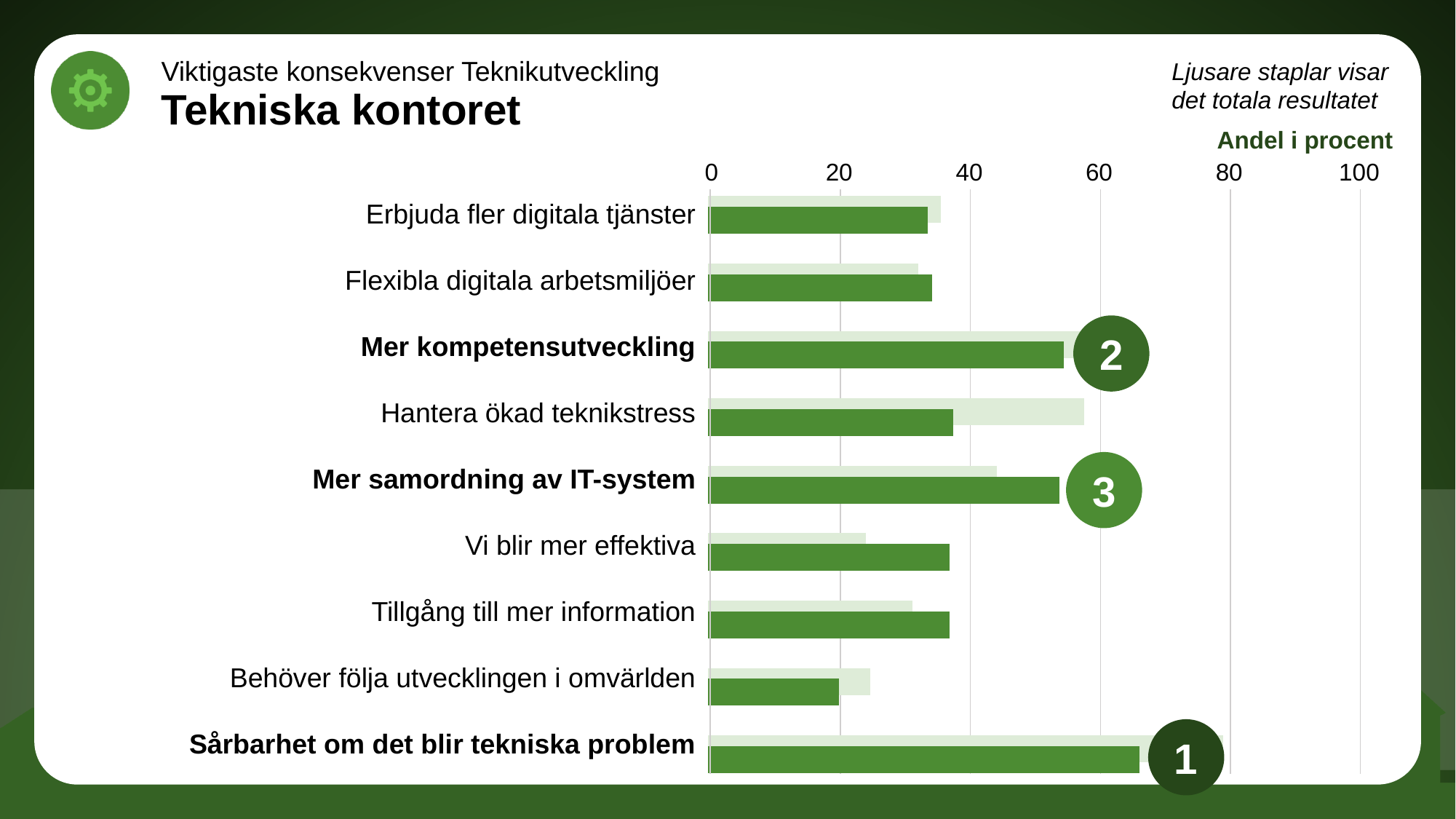
According to the note on the slide, what do the lighter bars show? det totala resultatet How many categories are plotted on the chart? 9 Which category has the highest dark green bar? Sårbarhet om det blir tekniska problem Is the dark green value for Behöver följa utvecklingen i omvärlden greater or less than 40? less Is the light green value for Hantera ökad teknikstress greater or less than 40? greater Which category has the lowest dark green bar? Behöver följa utvecklingen i omvärlden For Hantera ökad teknikstress, which bar is longer, the dark green or the light green one? light green Is the dark green value for Mer kompetensutveckling greater or less than 40? greater Which category is marked with the number 1 on the chart? Sårbarhet om det blir tekniska problem What kind of chart is shown on the slide? Bar chart For Vi blir mer effektiva, which bar is longer, the dark green or the light green one? dark green